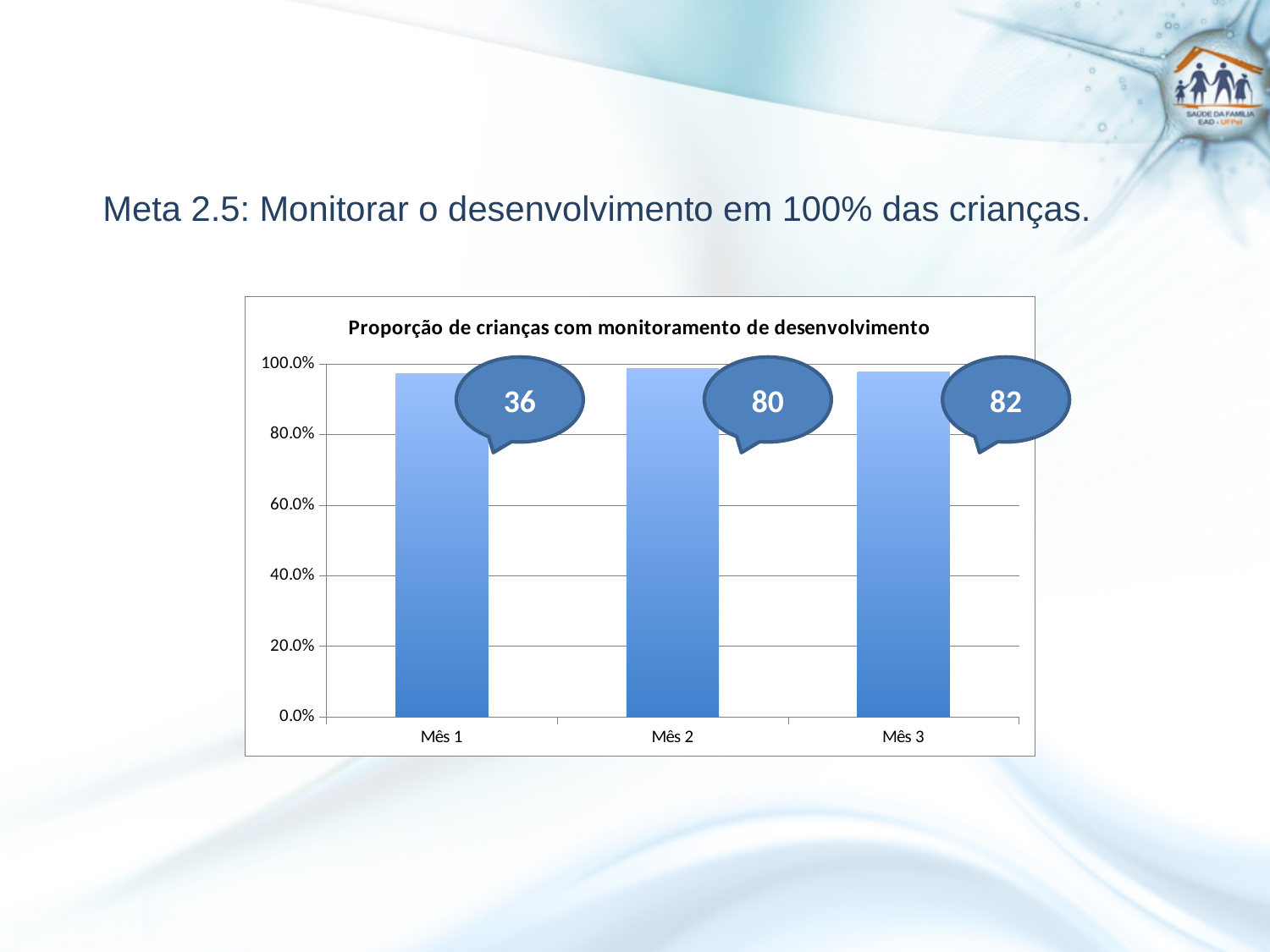
Is the value for Mês 3 greater or less than 60.0%? greater Is the value for Mês 2 greater or less than 80.0%? greater Is the value for Mês 1 greater or less than 100.0%? less What is the label of the first category on the x axis? Mês 1 How many categories (months) are plotted on the x axis of the chart? 3 What is the highest tick value shown on the y axis? 100.0% What kind of chart is shown on the slide? bar chart What is the title of the chart? Proporção de crianças com monitoramento de desenvolvimento What number is shown in the callout next to the Mês 1 bar? 36